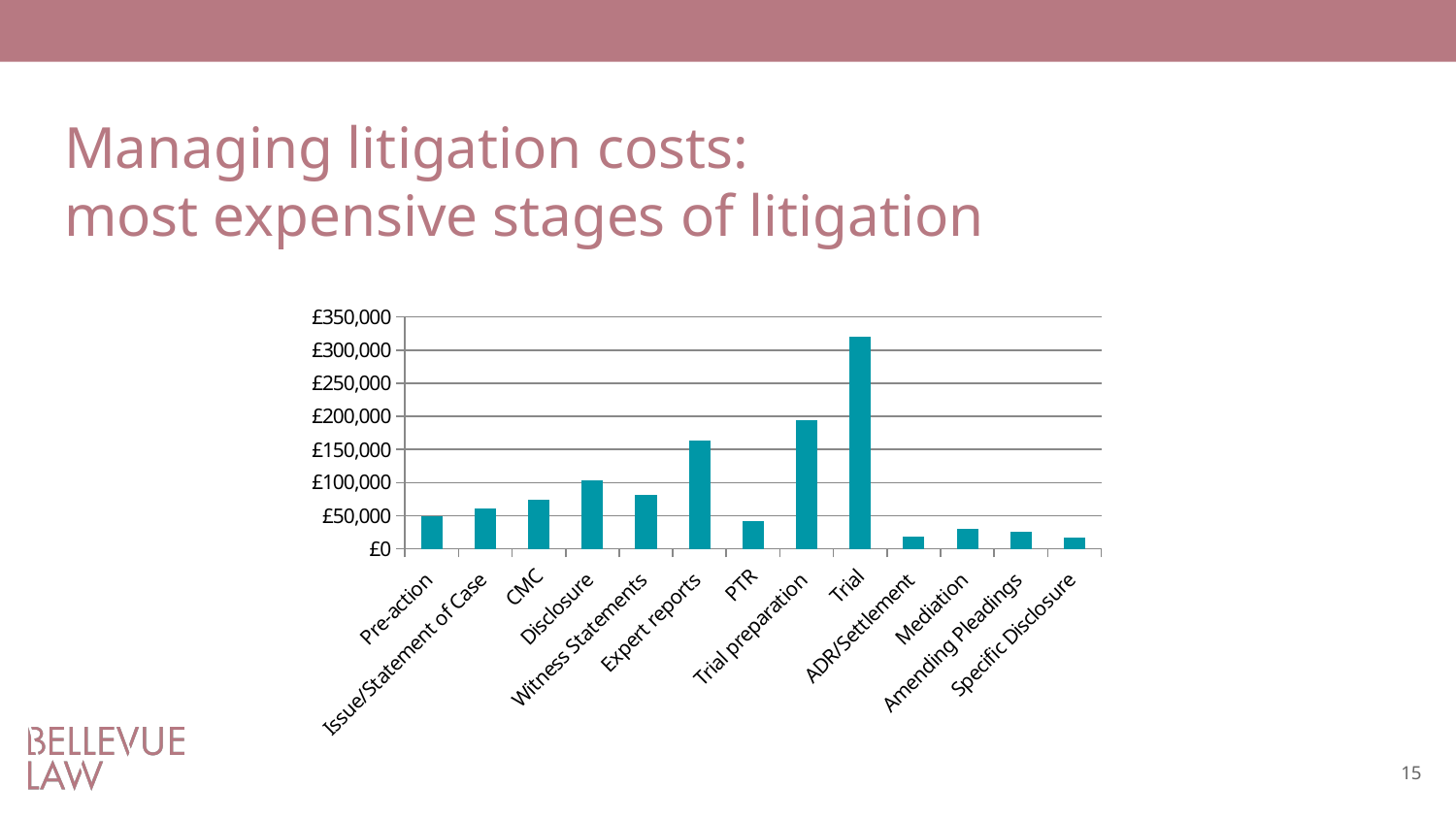
Which is larger, the value for Mediation or the value for ADR/Settlement? Mediation Is the value for Trial greater or less than £300,000? greater How many litigation stages are plotted on the chart? 13 Which is larger, the value for Trial preparation or the value for Expert reports? Trial preparation Is the value for CMC greater or less than £100,000? less What is the highest value shown on the vertical axis of the chart? £350,000 Is the value for PTR greater or less than £50,000? less Which is larger, the value for Disclosure or the value for Witness Statements? Disclosure Which litigation stage has the highest cost on the chart? Trial What kind of chart is shown on the slide? bar chart